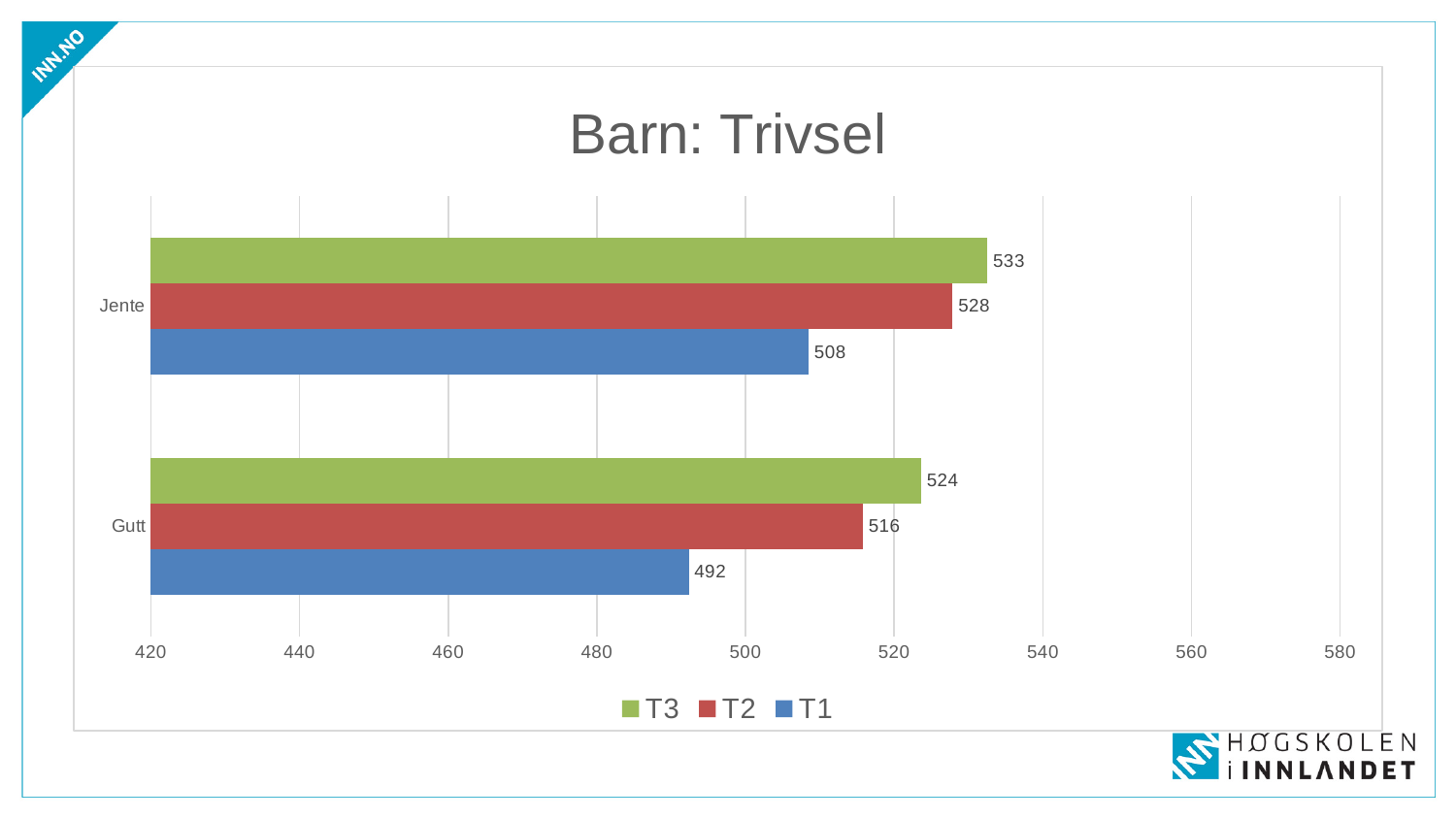
What is the title of the chart? Barn: Trivsel What is the value for Gutt in series T2? 516 Which is larger: the T1 value for Jente or the T2 value for Gutt? T2 value for Gutt What is the value for Jente in series T3? 533 Which category has the highest value in series T1? Jente What is the difference between the T3 and T1 values for Gutt? 32 What kind of chart is shown on the slide? Bar chart What is the value for Gutt in series T1? 492 How many series does the legend list? 3 Which category has the lowest value in series T3? Gutt What is the difference between the Jente and Gutt values in series T2? 12 What is the value for Jente in series T2? 528